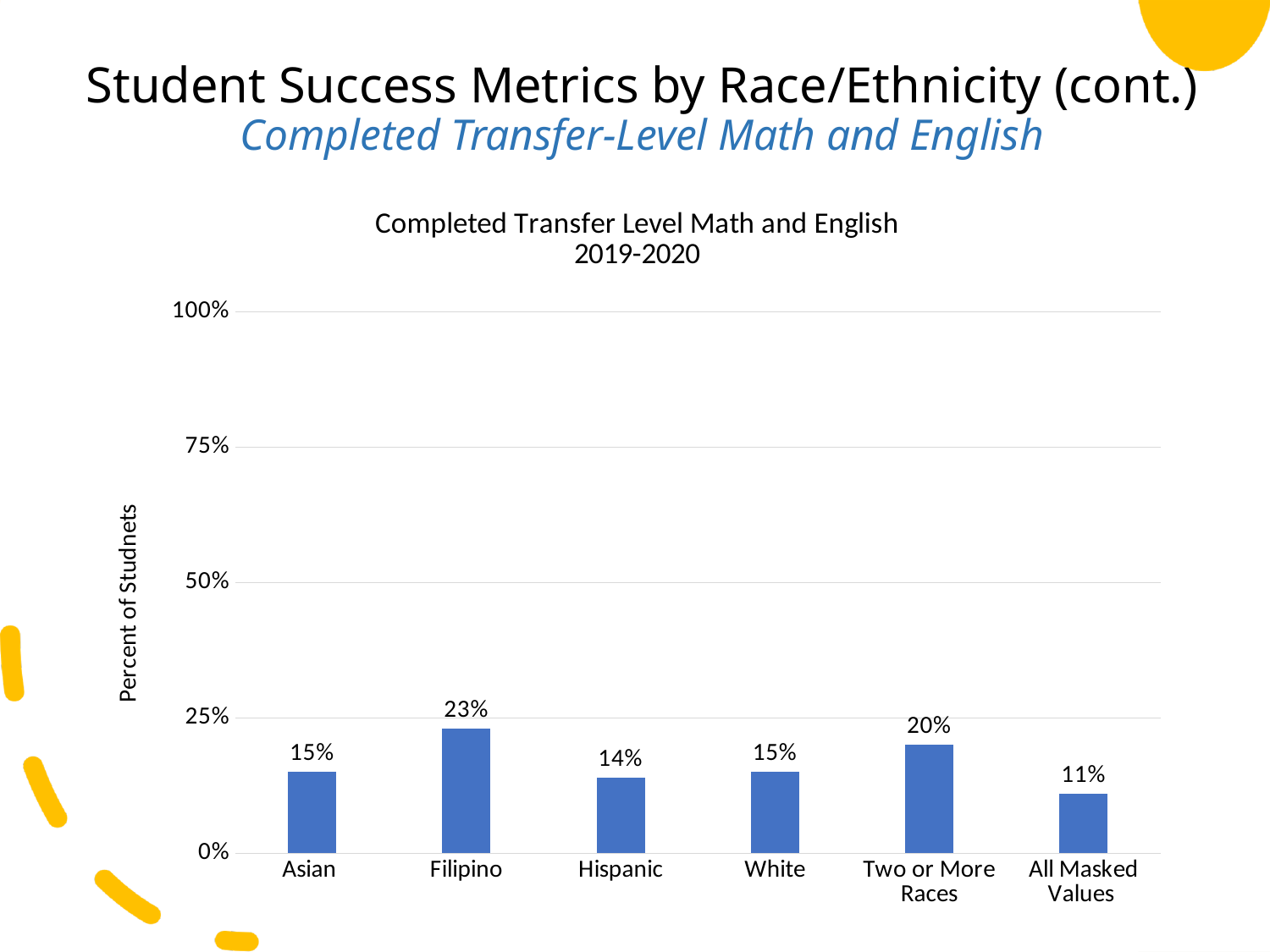
What is the label on the vertical axis of the chart? Percent of Studnets What is the value shown for Hispanic students? 14% Is the value for Filipino greater or less than 25%? less What is the difference between the Two or More Races value and the All Masked Values value? 9% How many race/ethnicity categories are shown on the x axis? 6 What is the difference between the Filipino and Hispanic percentages? 9% Which category has the highest percentage of students completing transfer-level math and English? Filipino What is the value shown for the All Masked Values category? 11% What kind of chart is shown on the slide? Bar chart What percentage of Filipino students completed transfer-level math and English in 2019-2020? 23% Which is larger, the value for Two or More Races or the value for White? Two or More Races Which category has the lowest percentage? All Masked Values